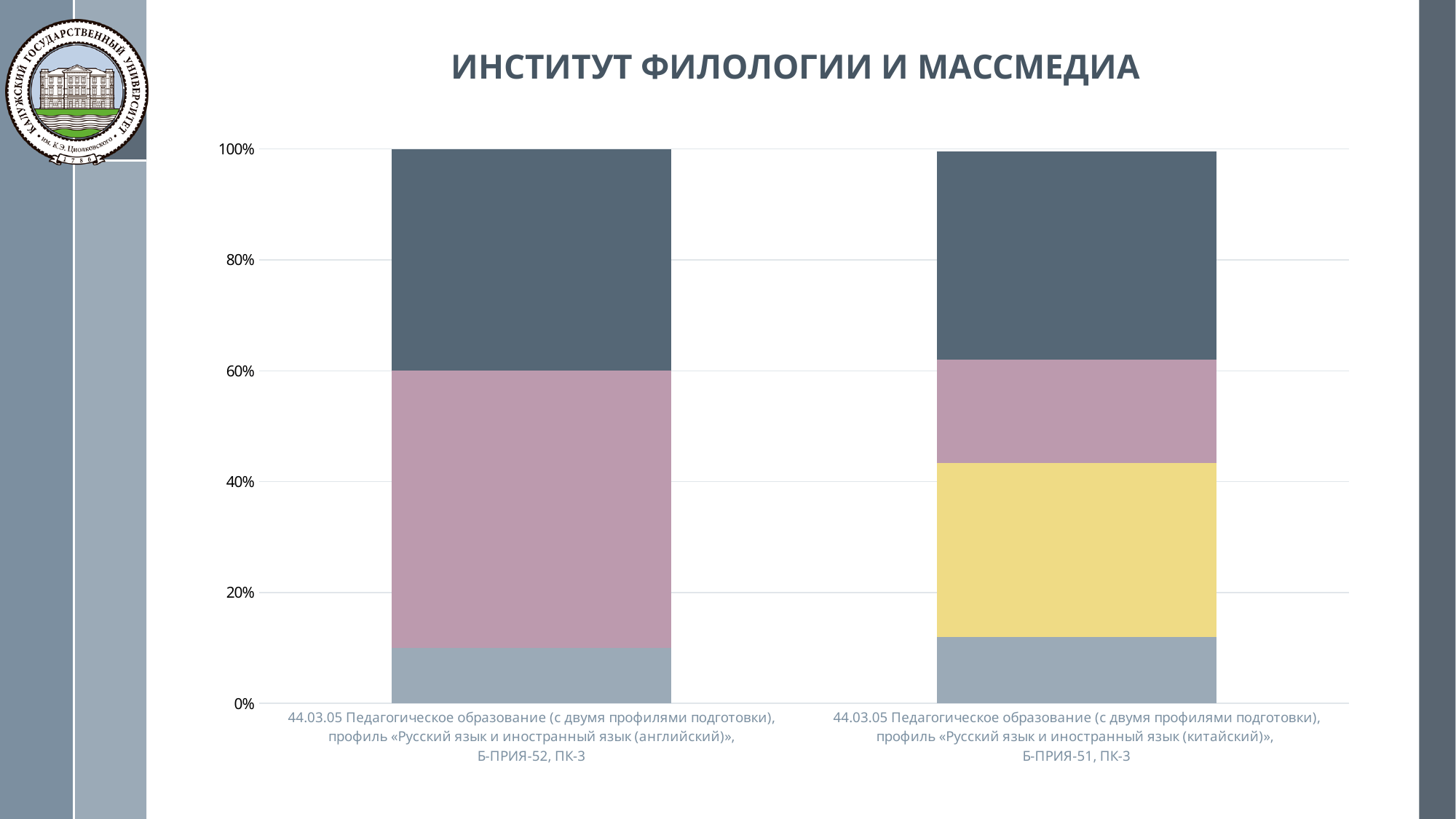
What is the total height of the left bar (Б-ПРИЯ-52, ПК-3) on the percentage axis? 100% Which bar contains a yellow segment? The right bar (Б-ПРИЯ-51, ПК-3) What kind of chart is shown on the slide? Stacked bar chart Which bar has the larger pink segment, the left bar (Б-ПРИЯ-52, ПК-3) or the right bar (Б-ПРИЯ-51, ПК-3)? The left bar (Б-ПРИЯ-52, ПК-3) What is the highest tick value shown on the vertical axis? 100% How many coloured segments make up the right bar (Б-ПРИЯ-51, ПК-3)? 4 Is the top of the yellow segment in the right bar (Б-ПРИЯ-51, ПК-3) greater or less than 40%? greater How many bars (categories) does the chart show? 2 How many coloured segments make up the left bar (Б-ПРИЯ-52, ПК-3)? 3 Is the top of the bottom grey segment in the left bar (Б-ПРИЯ-52, ПК-3) greater or less than 20%? less Is the top of the pink segment in the right bar (Б-ПРИЯ-51, ПК-3) greater or less than 80%? less What is the title shown at the top of the slide? ИНСТИТУТ ФИЛОЛОГИИ И МАССМЕДИА